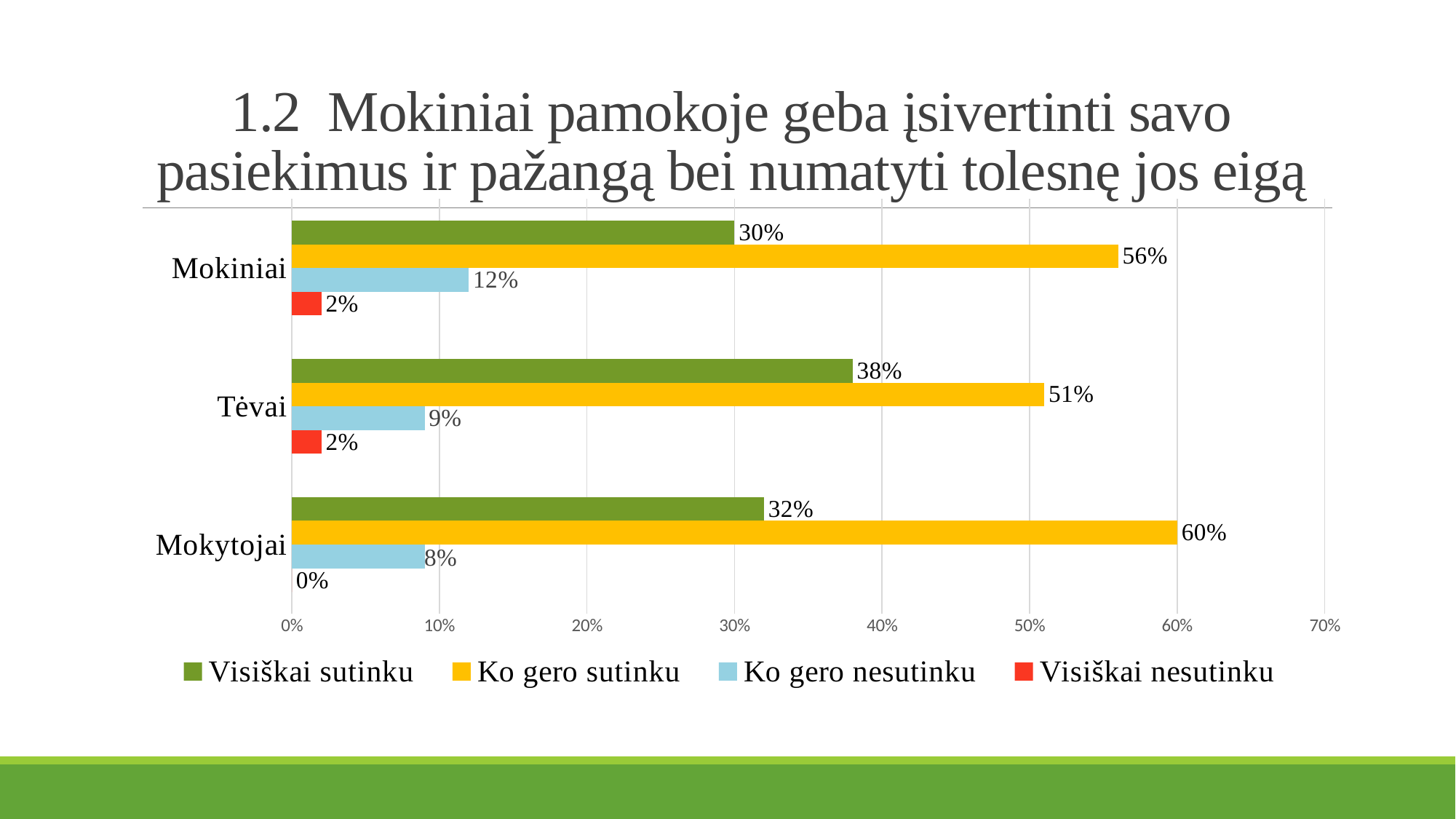
Which category has the highest value for "Ko gero sutinku"? Mokytojai Which category has the lowest value for "Visiškai sutinku"? Mokiniai Which colour represents "Visiškai nesutinku" in the legend? Red Which is larger: "Ko gero nesutinku" for Mokiniai or for Tėvai? Mokiniai How many categories are shown on the vertical axis? 3 How many series does the legend list? 4 What is the value for "Ko gero sutinku" for Mokiniai? 56% What is the value for "Ko gero nesutinku" for Mokytojai? 8% What is the value for "Visiškai sutinku" for Tėvai? 38% What kind of chart is shown on the slide? Bar chart What is the difference between the "Ko gero sutinku" values for Mokytojai and Tėvai? 9% What is the value for "Visiškai nesutinku" for Mokytojai? 0%